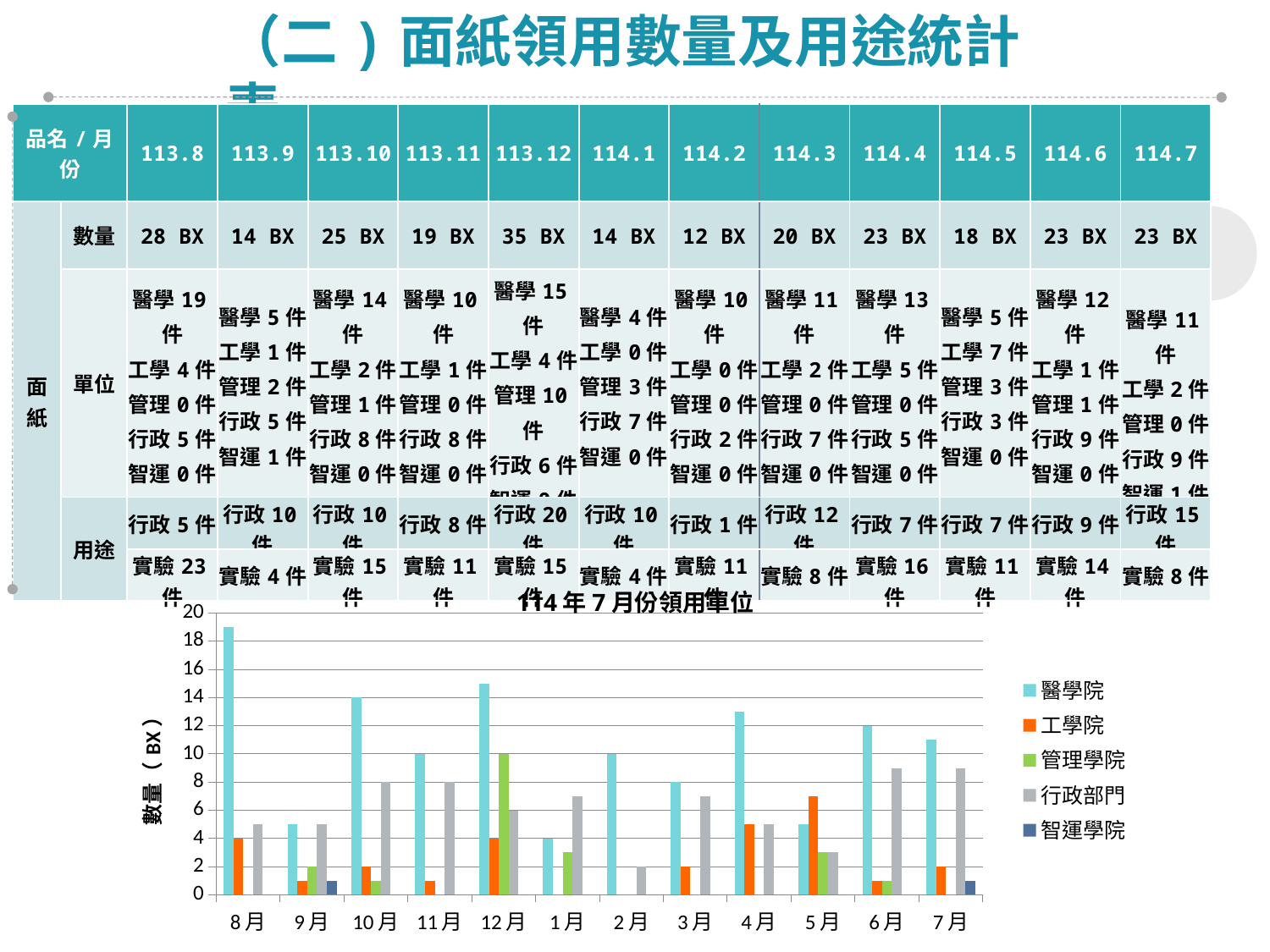
Which series in the bar chart is shown in orange? 工學院 In the bar chart, which month has the highest value for 醫學院? 8月 In the bar chart, is the value for 工學院 in 5月 greater or less than 6? greater How many series does the legend of the bar chart list? 5 What kind of chart is shown at the bottom of the slide? bar chart How many month categories are shown on the x axis of the bar chart? 12 In the bar chart, what is the value for 管理學院 in 12月? 10 In the bar chart, what is the value for 醫學院 in 10月? 14 In the bar chart, which is larger: 醫學院 in 8月 or 醫學院 in 9月? 醫學院 in 8月 In the bar chart, is the value for 醫學院 in 8月 greater or less than 18? greater In the bar chart, what is the value for 行政部門 in 11月? 8 In the bar chart, what is the value for 醫學院 in 6月? 12